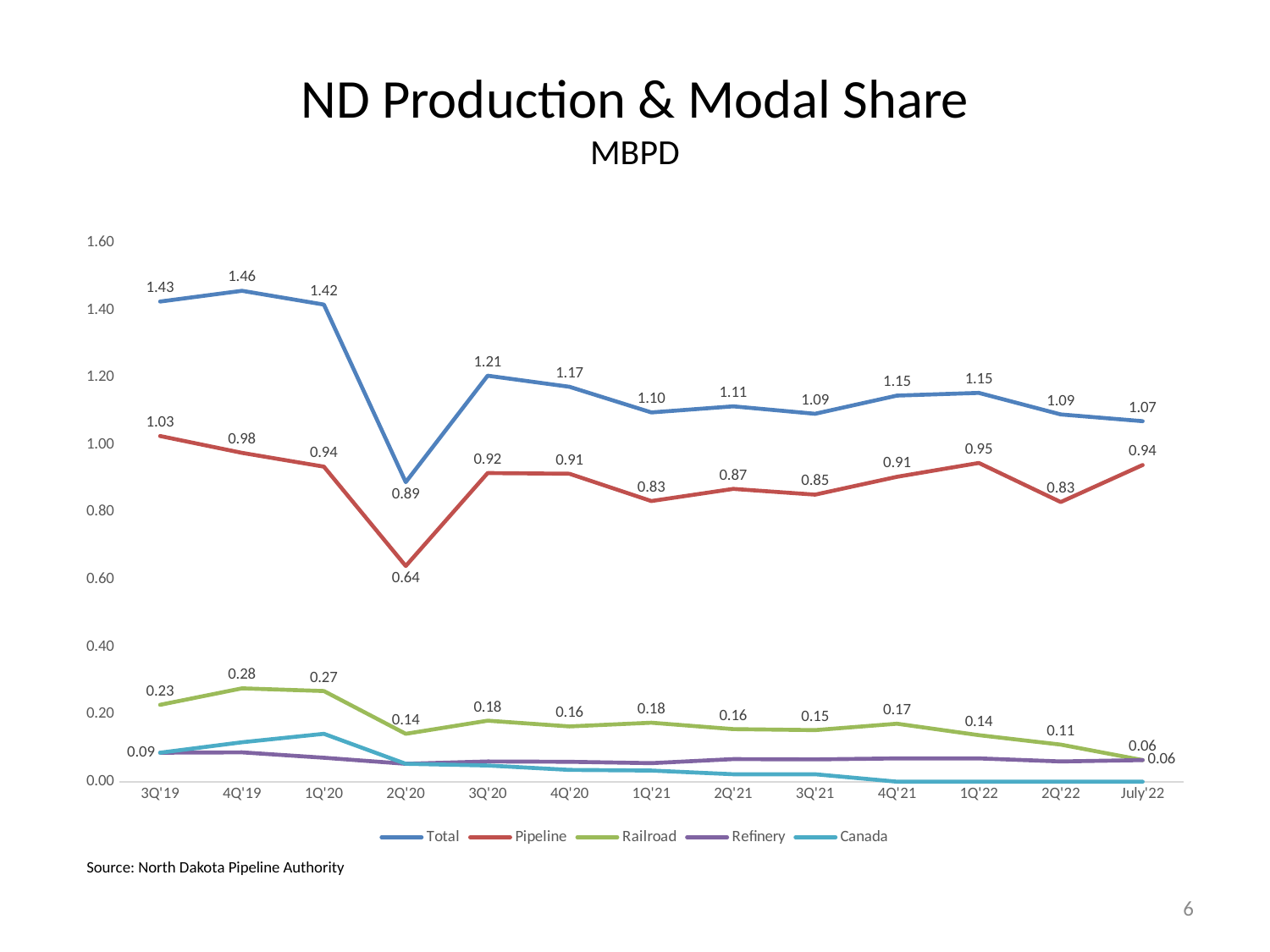
How many time periods are shown on the x axis? 13 What is the Railroad value for 1Q'20? 0.27 Which is larger, the Pipeline value in 1Q'22 or in 2Q'22? 1Q'22 What is the Pipeline value for 2Q'20? 0.64 What is the source cited below the chart? North Dakota Pipeline Authority What kind of chart is shown on the slide? line chart How many series does the legend list? 5 What is the Total value for 4Q'19? 1.46 In which period is the Total series at its highest? 4Q'19 In which period is the Pipeline series at its lowest? 2Q'20 Is the Canada value for 1Q'20 greater or less than 0.20? less What is the difference between the Total value in 1Q'20 and in 2Q'20? 0.53